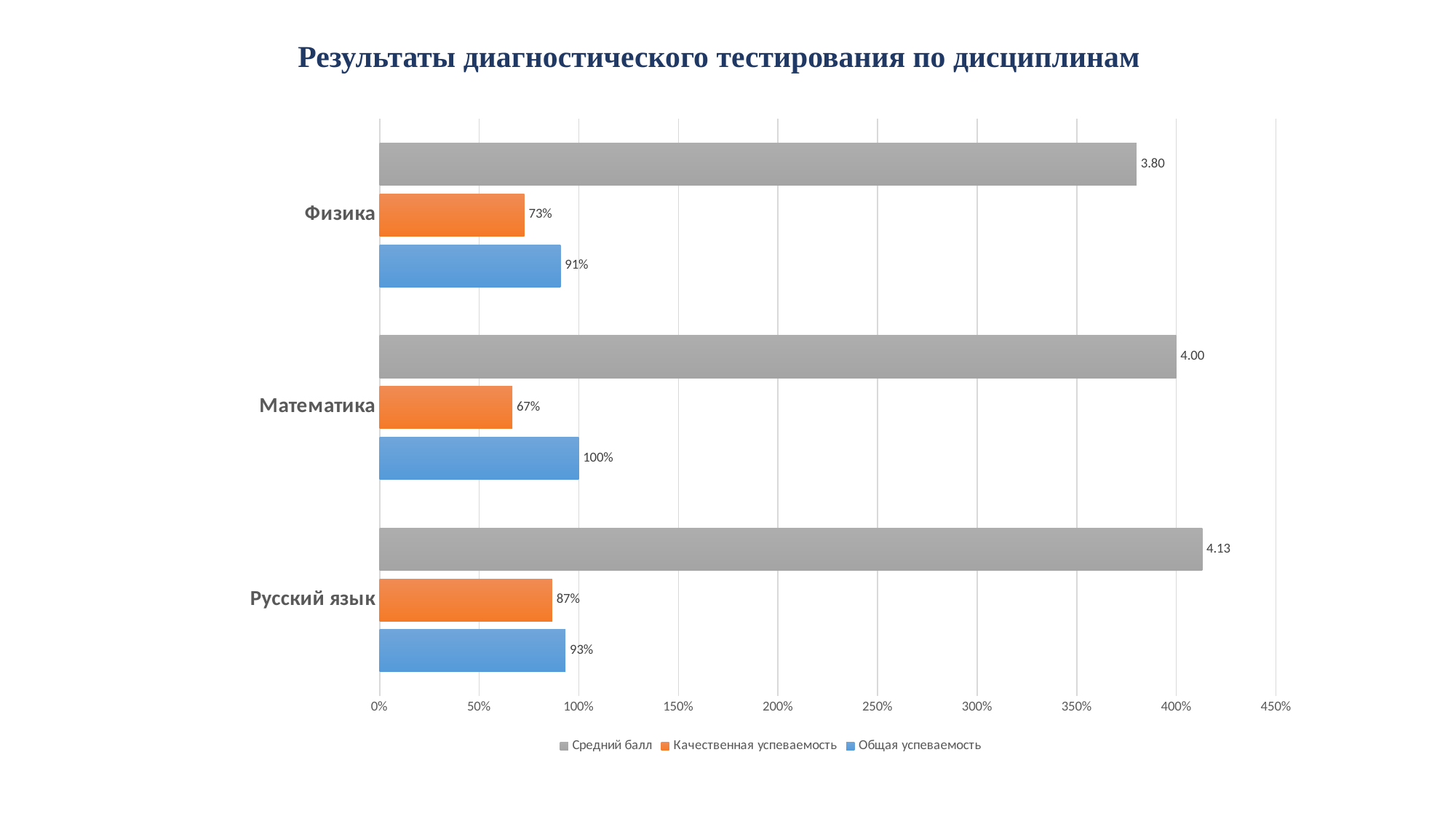
What is the Качественная успеваемость value for Математика? 67% What is the title of the chart? Результаты диагностического тестирования по дисциплинам What kind of chart is shown on the slide? Bar chart How many series does the legend list? 3 What is the Общая успеваемость value for Русский язык? 93% Which discipline has the highest Средний балл? Русский язык Which discipline has the lowest Качественная успеваемость? Математика How many disciplines are shown on the chart? 3 Is the Общая успеваемость value for Физика greater or less than 50%? greater What is the difference between the Общая успеваемость values for Математика and Физика? 9% What is the Средний балл value for Физика? 3.80 Which is larger: the Качественная успеваемость for Русский язык or for Физика? Русский язык